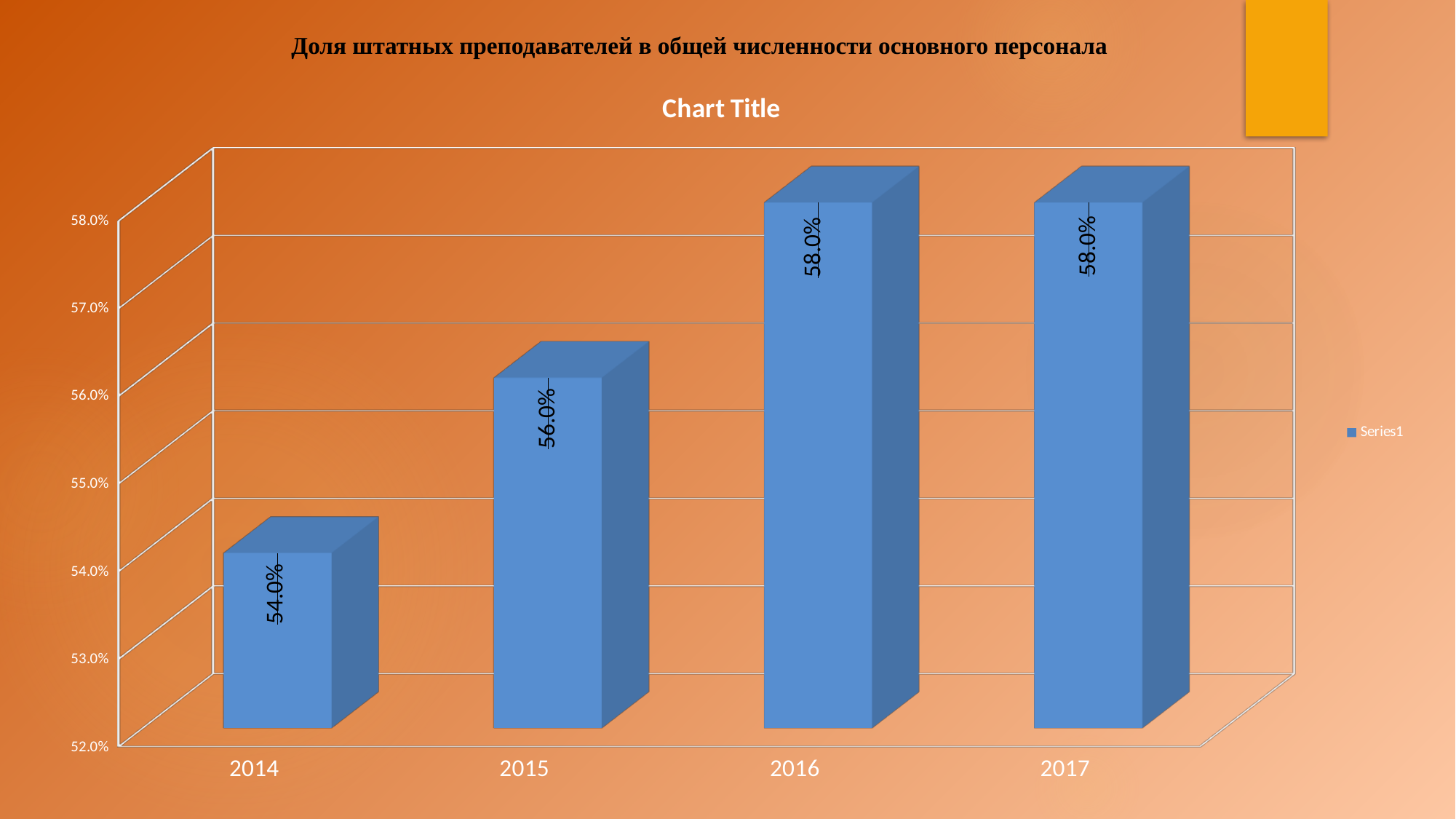
What kind of chart is this? bar chart What is the value for 2015? 56.0% What is the difference between the values for 2015 and 2014? 2.0% What is the value for 2016? 58.0% Do the values rise or fall from 2014 to 2016? rise Which year has the lowest value? 2014 What is the value for 2017? 58.0% How many series does the legend list? 1 What is the value for 2014? 54.0% How many years are shown on the x axis? 4 What is the difference between the values for 2016 and 2014? 4.0% Which is larger, the value for 2015 or the value for 2016? 2016